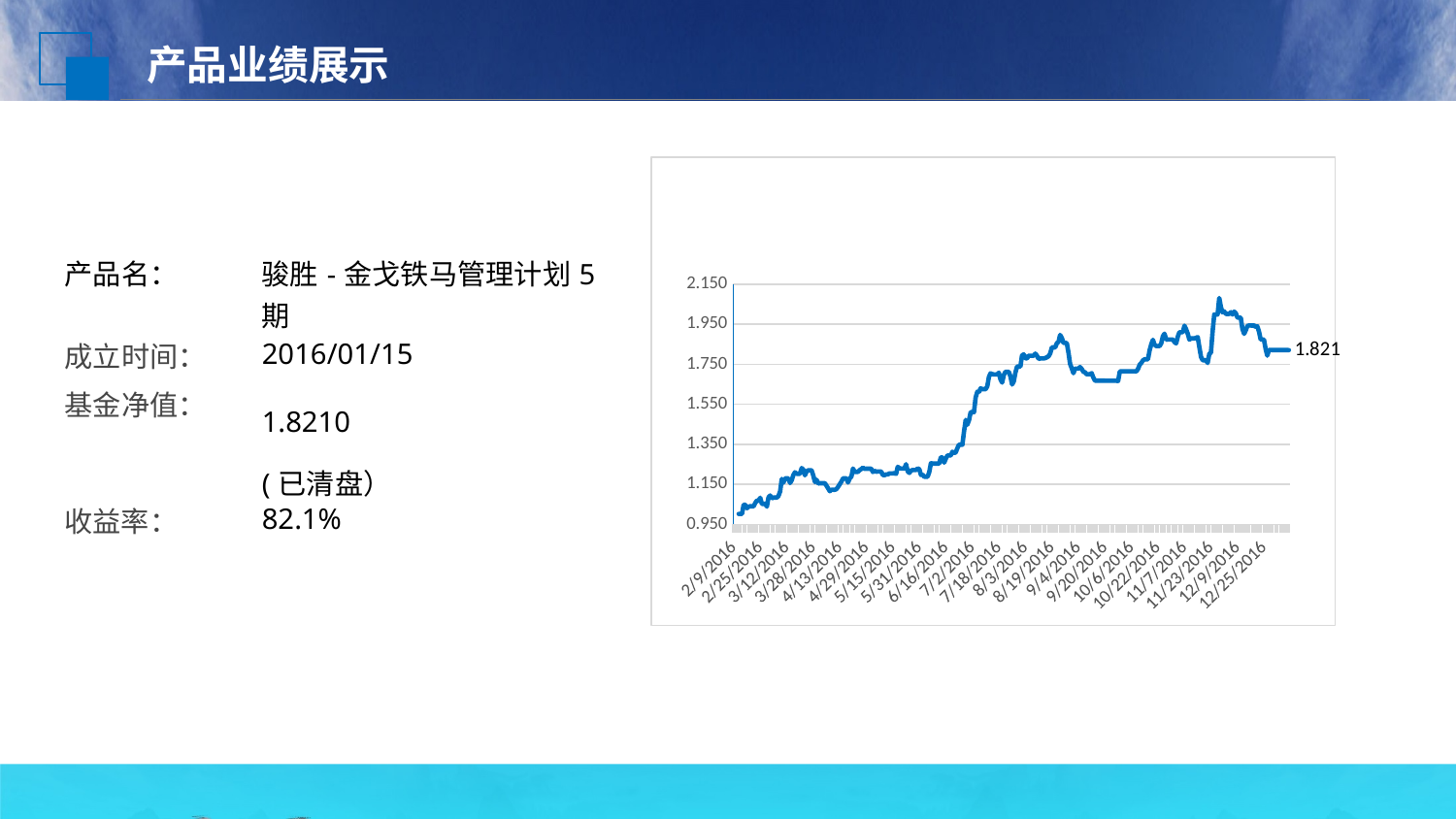
Is the highest point of the line greater or less than 1.950? greater What is the highest tick value shown on the y axis? 2.150 What is the last date label shown on the x axis? 12/25/2016 Is the value at 4/13/2016 greater or less than 1.350? less What is the value shown by the data label at the end of the line? 1.821 Is the value at 2/9/2016 greater or less than 1.150? less Overall, does the line rise or fall from the start of the x axis to the end? rise What kind of chart is shown on the slide? line chart